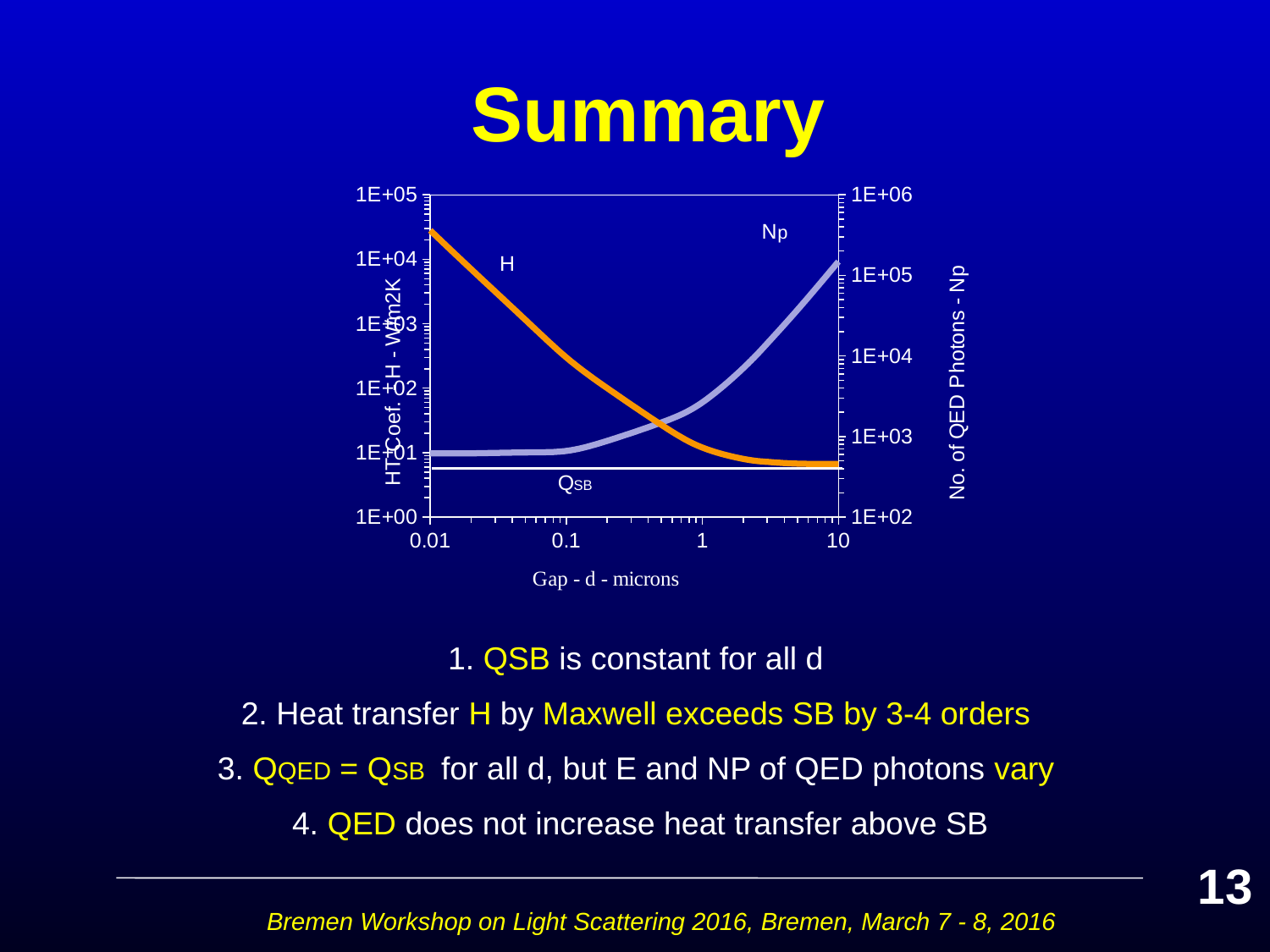
What kind of chart is shown on the slide? line chart Does the Np line rise or fall as the gap d increases from 0.01 to 10 microns? rise Is the value of Np at a gap of 0.01 microns greater or less than 1E+04 on the right axis? less How many lines are plotted on the chart? 3 Which line on the chart stays constant across all values of the gap d? QSB Is the value of H at a gap of 10 microns greater or less than 1E+02 on the left axis? less What is the title of the x axis of the chart? Gap - d - microns Is the value of Np at a gap of 10 microns greater or less than 1E+04 on the right axis? greater Does the H line rise or fall as the gap d increases from 0.01 to 10 microns? fall